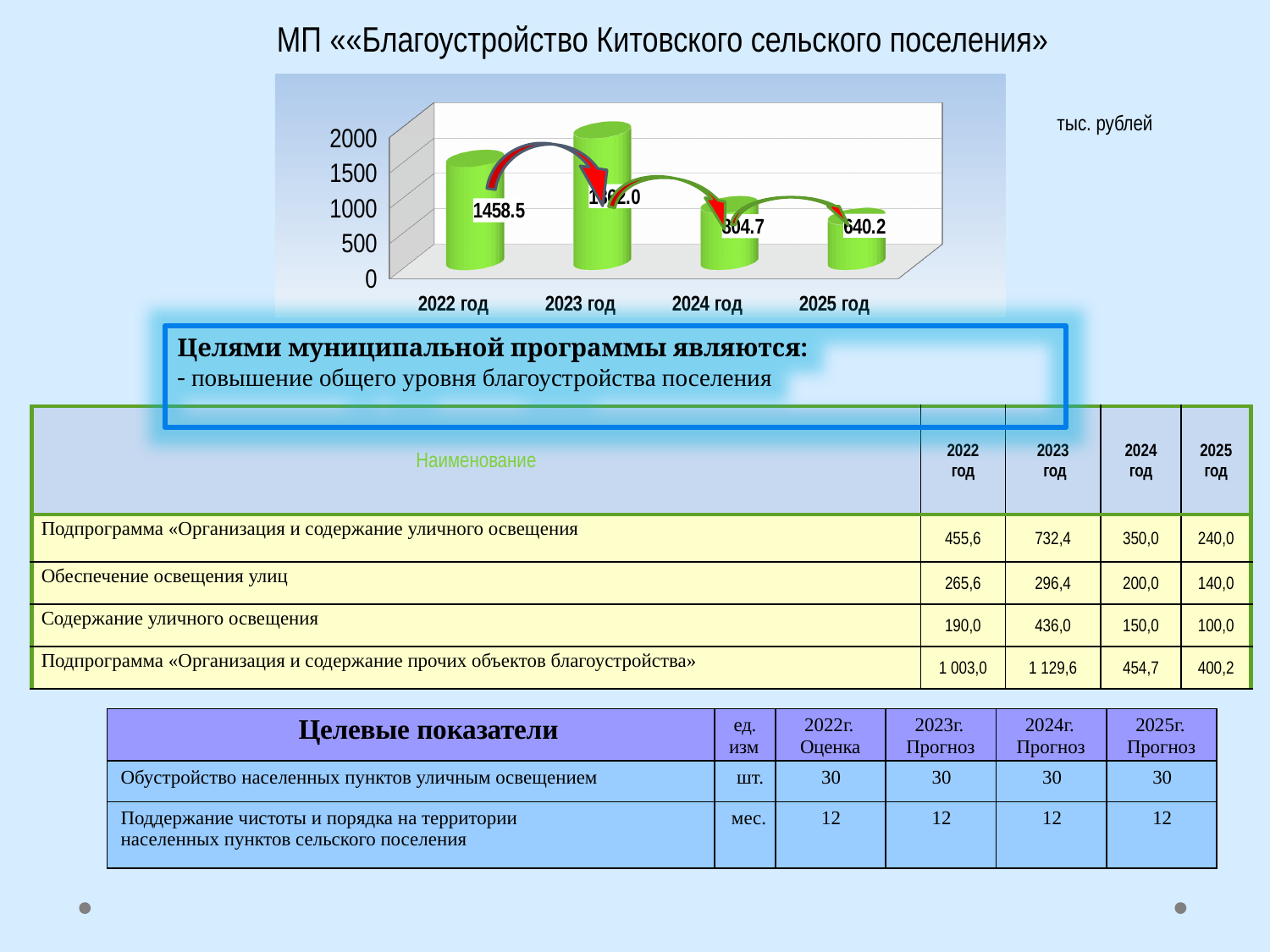
What unit is indicated next to the chart? тыс. рублей Is the value for 2023 год greater or less than 1500? greater What is the value for 2025 год? 640.2 Is the value for 2024 год greater or less than 1000? less Which year has the lowest bar? 2025 год What is the difference between the values for 2022 год and 2025 год? 818.3 Which is larger, the value for 2022 год or the value for 2025 год? 2022 год How many years are shown on the x axis of the chart? 4 Which year has the highest bar? 2023 год What kind of chart is shown on the slide? bar chart What is the value for 2022 год? 1458.5 Do the values rise or fall from 2023 год to 2025 год? fall